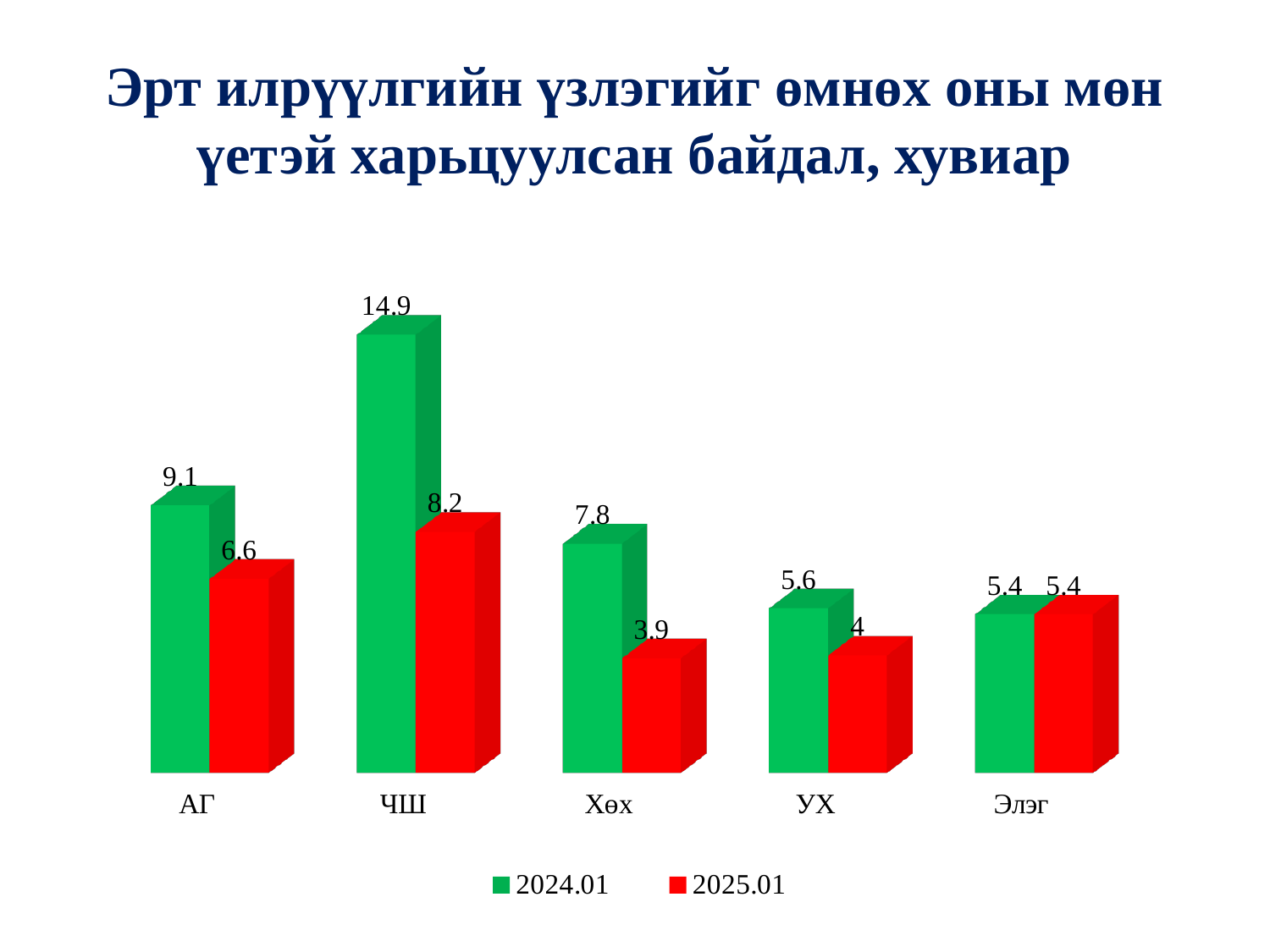
What is the value for ЧШ in the 2024.01 series? 14.9 Which colour represents the 2025.01 series? Red What is the difference between the 2024.01 and 2025.01 values for ЧШ? 6.7 What kind of chart is shown on the slide? Bar chart How many series does the legend list? 2 What is the value for УХ in the 2025.01 series? 4 Which category has the lowest value in the 2025.01 series? Хөх What is the value for Хөх in the 2025.01 series? 3.9 What is the difference between the 2024.01 and 2025.01 values for АГ? 2.5 How many categories are shown on the x axis? 5 Which category has the highest value in the 2024.01 series? ЧШ Which is larger for Хөх: the 2024.01 value or the 2025.01 value? 2024.01